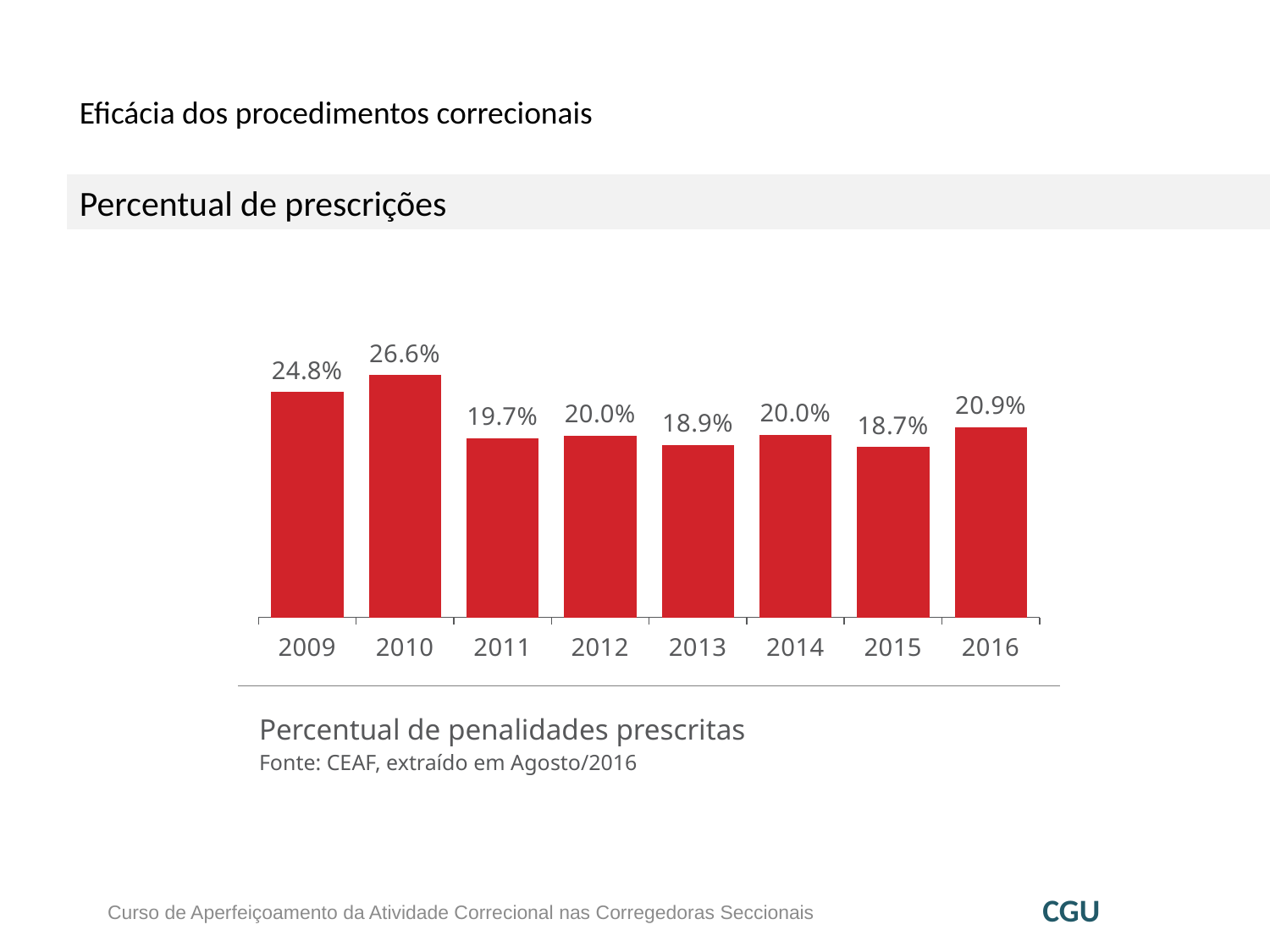
Do the values rise or fall from 2010 to 2011? Fall How many years are shown on the x axis? 8 What kind of chart is this? Bar chart What is the difference between the values for 2010 and 2009? 1.8% What is the value for 2015? 18.7% What is the value for 2016? 20.9% Which year has the highest value? 2010 What is the difference between the values for 2016 and 2015? 2.2% Which year has the lowest value? 2015 What is the caption below the chart? Percentual de penalidades prescritas Which is larger, the value for 2009 or the value for 2011? 2009 What is the value for 2010? 26.6%